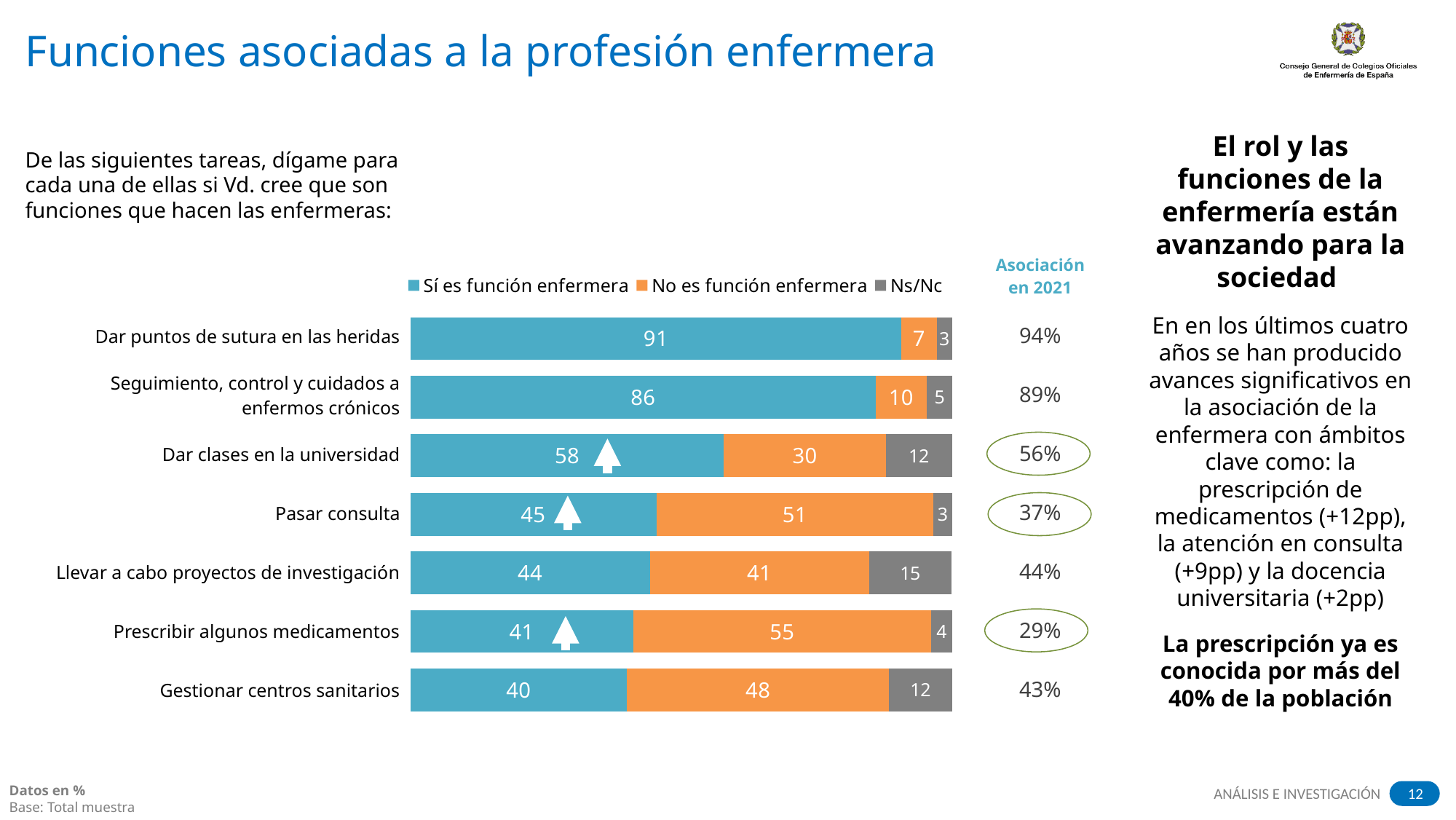
What is the 'Sí es función enfermera' value for 'Dar puntos de sutura en las heridas'? 91 Which category has the highest 'Sí es función enfermera' value? Dar puntos de sutura en las heridas What is the 'No es función enfermera' value for 'Prescribir algunos medicamentos'? 55 For 'Pasar consulta', which is larger: 'Sí es función enfermera' or 'No es función enfermera'? No es función enfermera What kind of chart is shown on the slide? Stacked bar chart What is the total of the stacked bar for 'Dar clases en la universidad'? 100 How many categories does the chart show? 7 What is the 'Ns/Nc' value for 'Llevar a cabo proyectos de investigación'? 15 What is the 'Asociación en 2021' value shown for 'Prescribir algunos medicamentos'? 29% Which category has the lowest 'Sí es función enfermera' value? Gestionar centros sanitarios How many series does the legend list? 3 What is the difference between the 'Sí es función enfermera' values for 'Dar clases en la universidad' and 'Pasar consulta'? 13